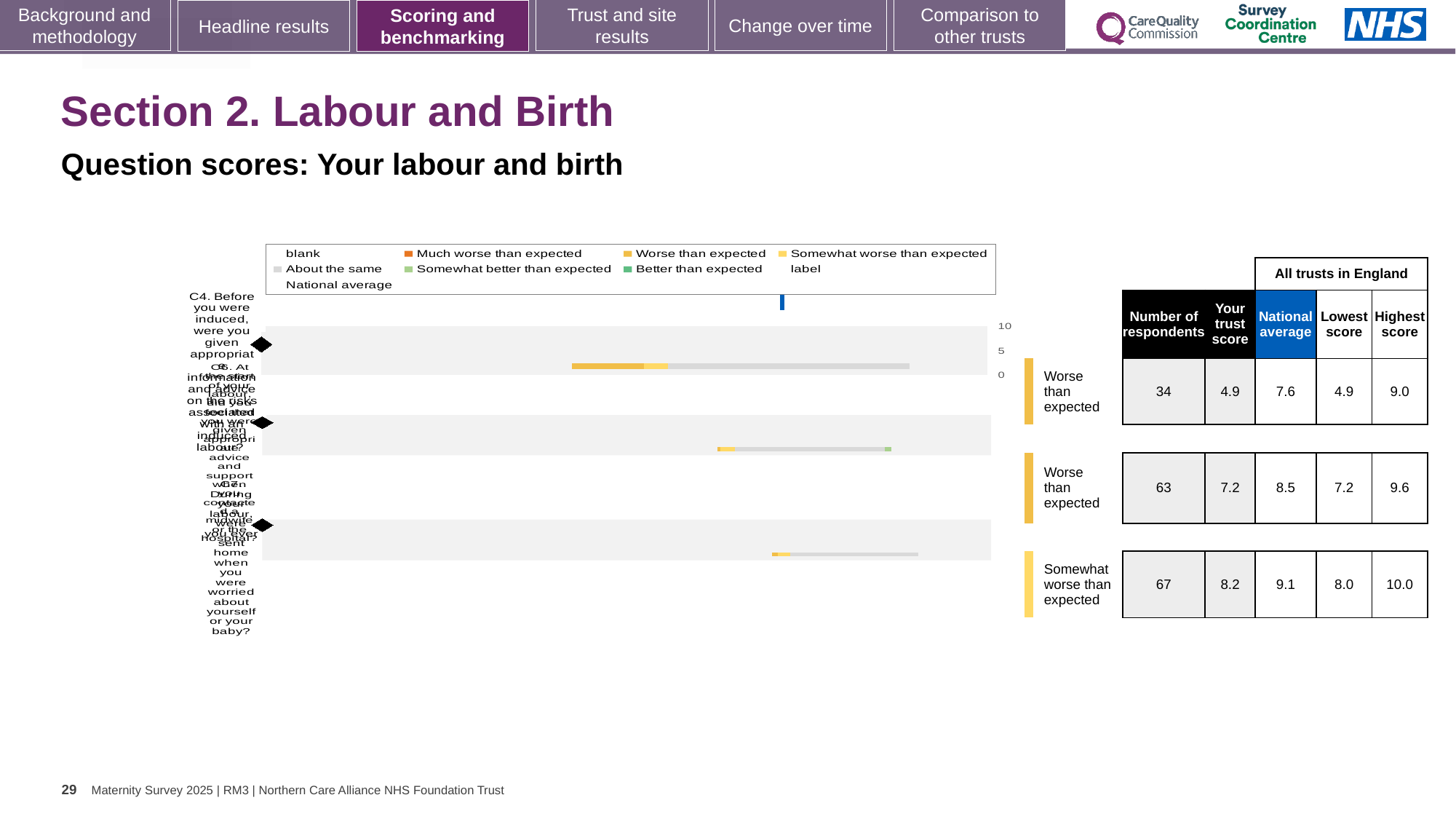
What rating label is shown next to the third row of the table? Somewhat worse than expected In the legend, what colour represents 'Much worse than expected'? orange In the table, what is the highest score for the third row? 10.0 For the first row (C4), what is the difference between the national average and the trust score? 2.7 In the table, what is the lowest score for the second row? 7.2 For the second row, which is larger: the trust score or the national average? the national average What kind of chart is shown on the slide? bar chart Which row in the table has the highest number of respondents? the third row (67) In the table, what is the trust score for the first row (C4)? 4.9 How many question rows (bars) are plotted in the chart? 3 In the table, what is the number of respondents for the first row (C4)? 34 In the table, what is the national average for the second row? 8.5